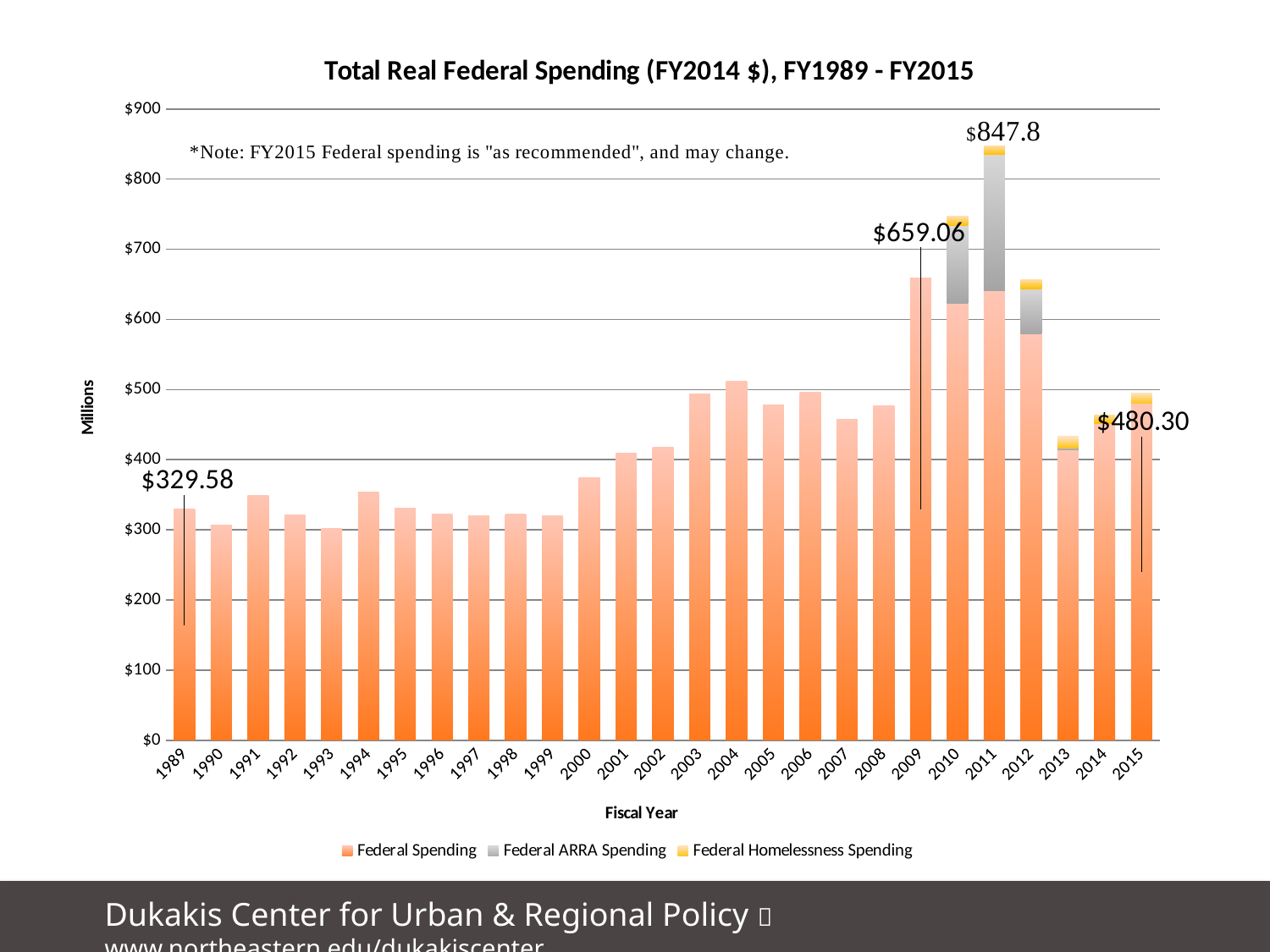
How many series does the legend list? 3 Which is larger, the labeled value for FY2009 or for FY2015? FY2009 Is the total value for FY2010 greater or less than $700? greater What is the difference between the labeled values for FY2009 and FY2015? $178.76 Is the value for FY2000 greater or less than $400? less What value is labeled for FY2011? $847.8 What value is labeled for FY2015? $480.30 What is the total real federal spending value labeled for FY1989? $329.58 What value is labeled for FY2009? $659.06 What kind of chart is shown on the slide? Stacked bar chart How many fiscal years are shown on the x axis? 27 Which fiscal year has the highest total bar? 2011